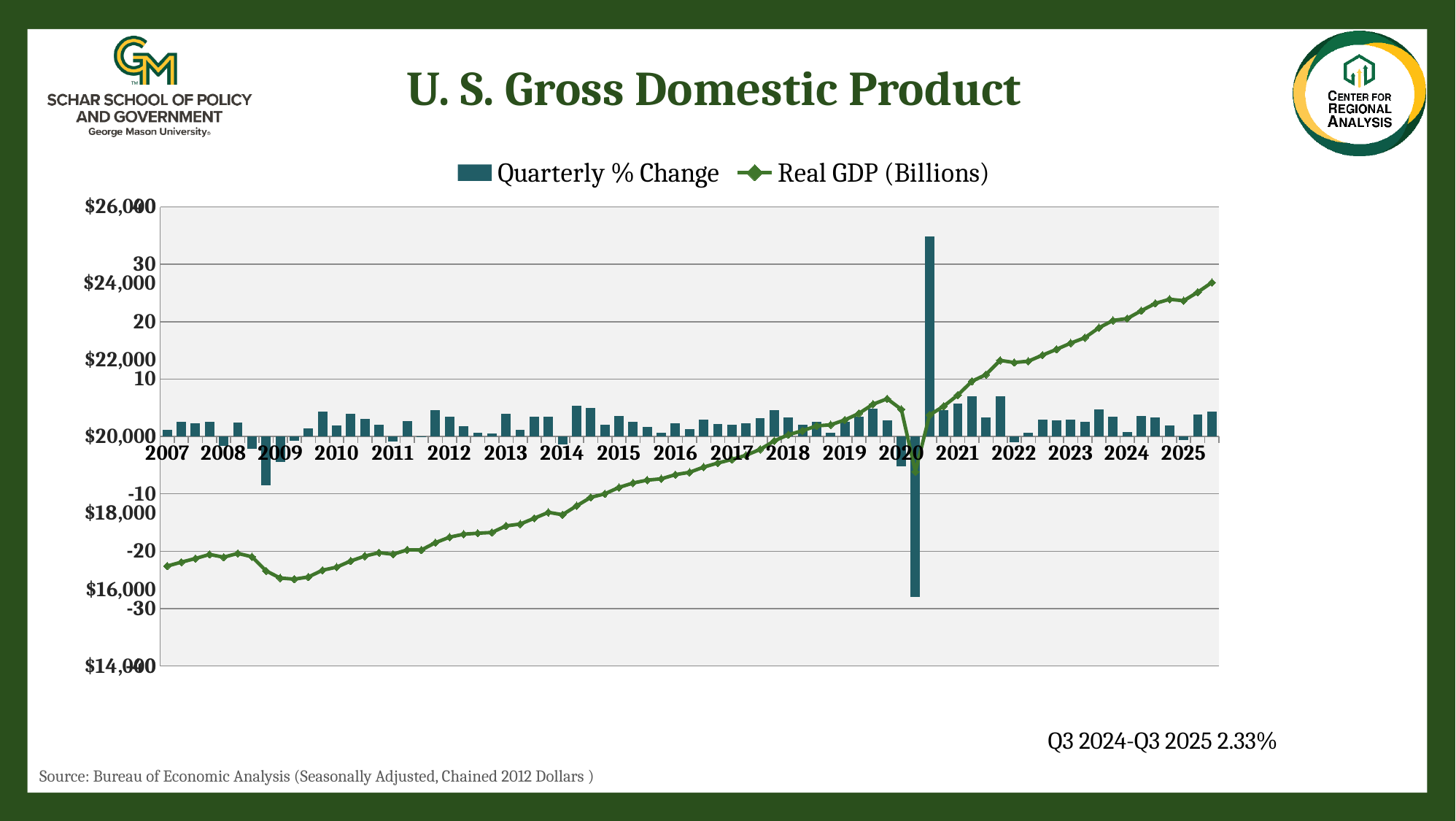
Is the lowest Quarterly % Change bar, in 2020, greater or less than -20? less Does the Real GDP (Billions) line rise or fall overall from 2007 to 2025? Rises Is the tallest positive Quarterly % Change bar, in 2020, greater or less than 30? greater In which year does the Real GDP (Billions) line reach its highest value? 2025 What kind of chart is shown on the slide? Combined bar and line chart Is the Real GDP (Billions) value at the end of 2025 greater or less than $22,000? greater How many series does the chart legend list? 2 What is the title of the chart? U. S. Gross Domestic Product Does the Real GDP (Billions) line rise or fall between 2008 and 2009? Falls In which year does the Quarterly % Change series have its tallest bar? 2020 Which is larger, the Real GDP (Billions) value in 2025 or in 2007? 2025